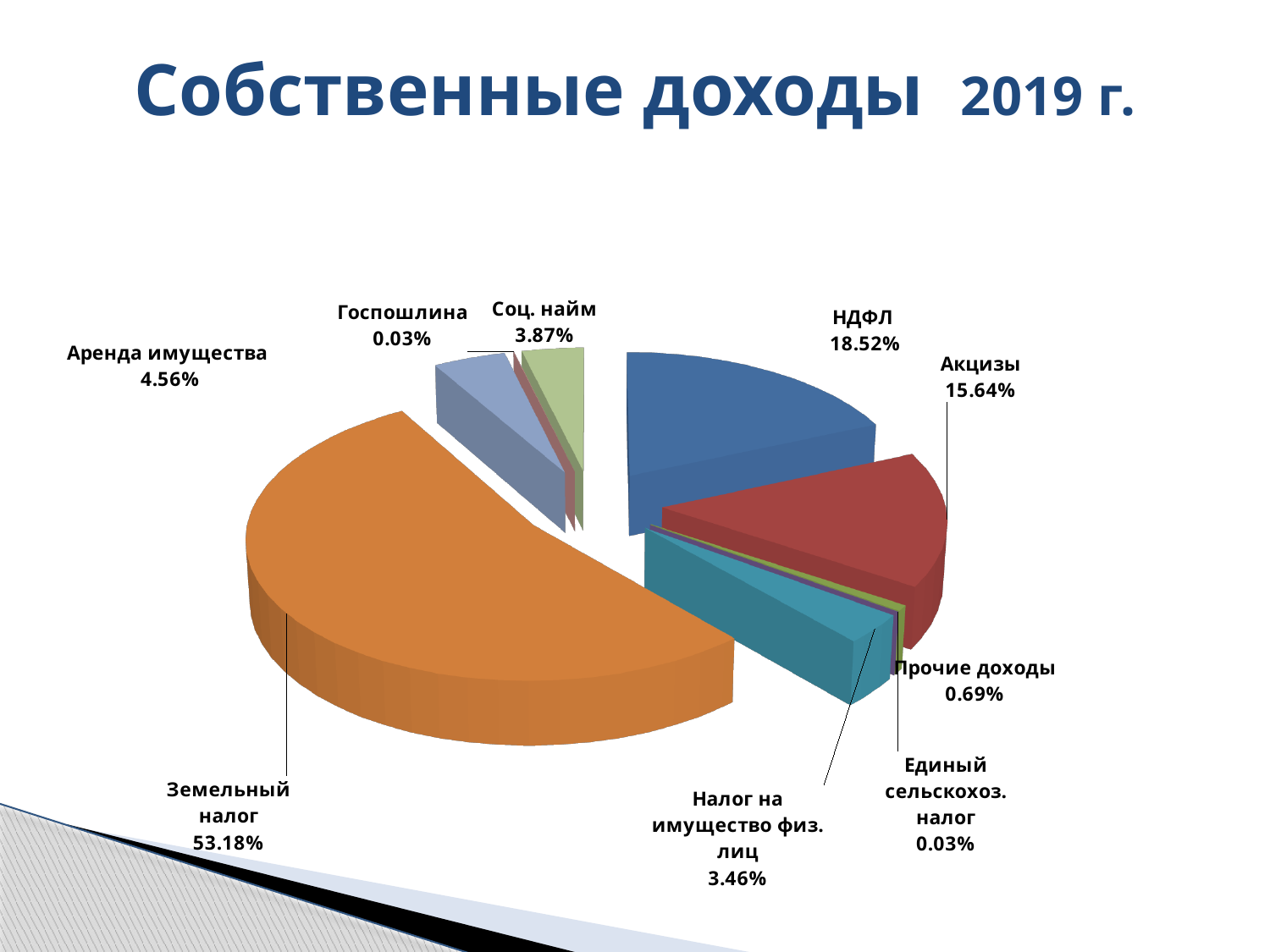
Which is larger, НДФЛ or Акцизы? НДФЛ What is the value shown for Аренда имущества? 4.56% How many categories are shown in the pie chart? 9 What is the difference between the shares of НДФЛ and Акцизы? 2.88% What share of own revenues does Земельный налог account for? 53.18% What is the value shown for Акцизы? 15.64% What is the title of the slide? Собственные доходы 2019 г. What is the value shown for НДФЛ? 18.52% Which category has the largest share of the pie? Земельный налог What is the value shown for Прочие доходы? 0.69% What kind of chart is shown on the slide? pie chart What is the value shown for Налог на имущество физ. лиц? 3.46%